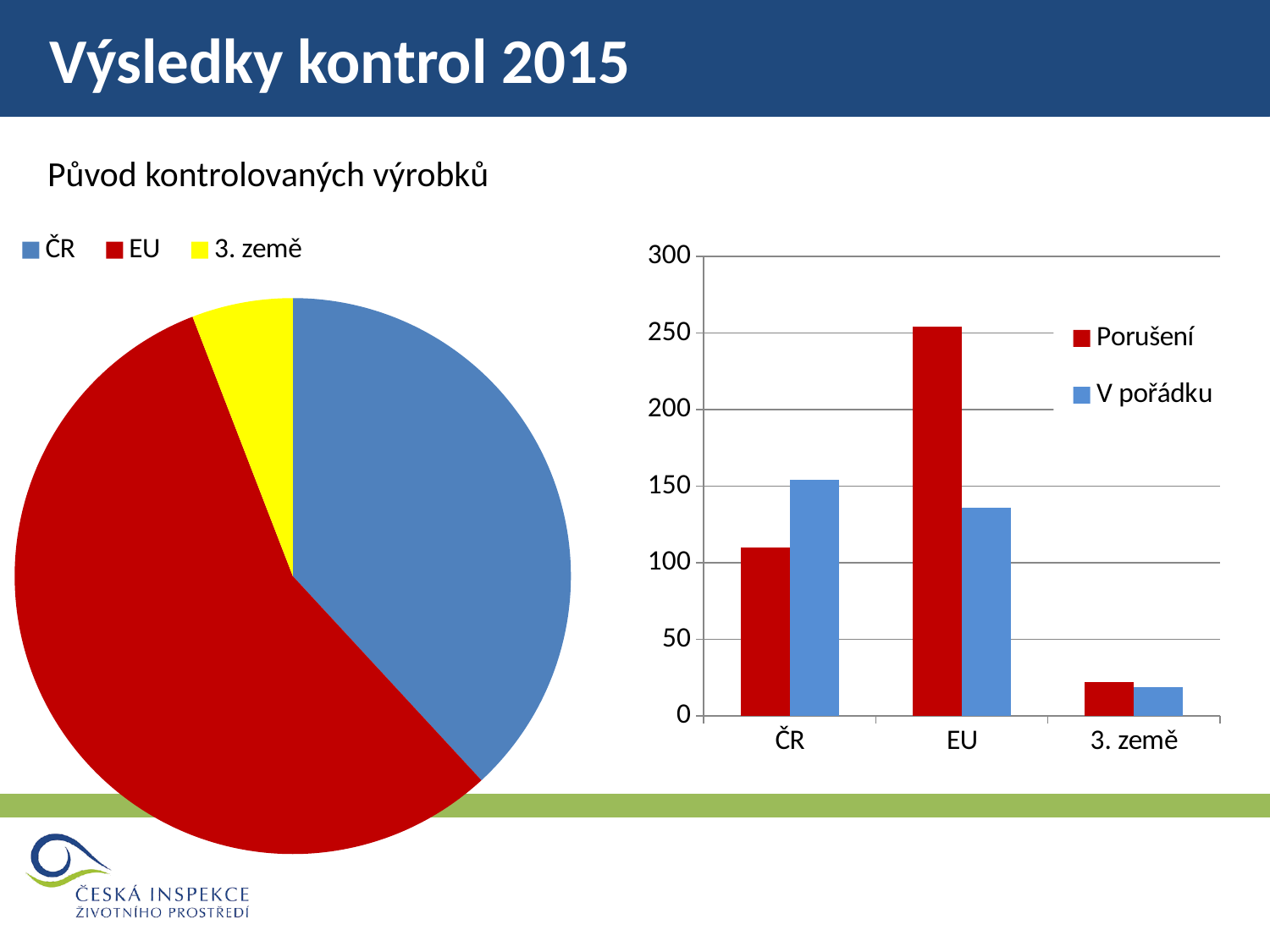
In the pie chart on the left, which category has the smallest slice? 3. země In the bar chart on the right, which category has the lowest V pořádku value? 3. země In the bar chart on the right, for ČR, which is larger: Porušení or V pořádku? V pořádku How many slices does the pie chart on the left have? 3 What kind of chart is the chart on the left of the slide? pie chart In the bar chart on the right, for EU, which is larger: Porušení or V pořádku? Porušení In the bar chart on the right, which category has the highest Porušení value? EU How many series does the legend of the bar chart on the right list? 2 What kind of chart is the chart on the right of the slide? bar chart In the pie chart on the left, which category has the largest slice? EU